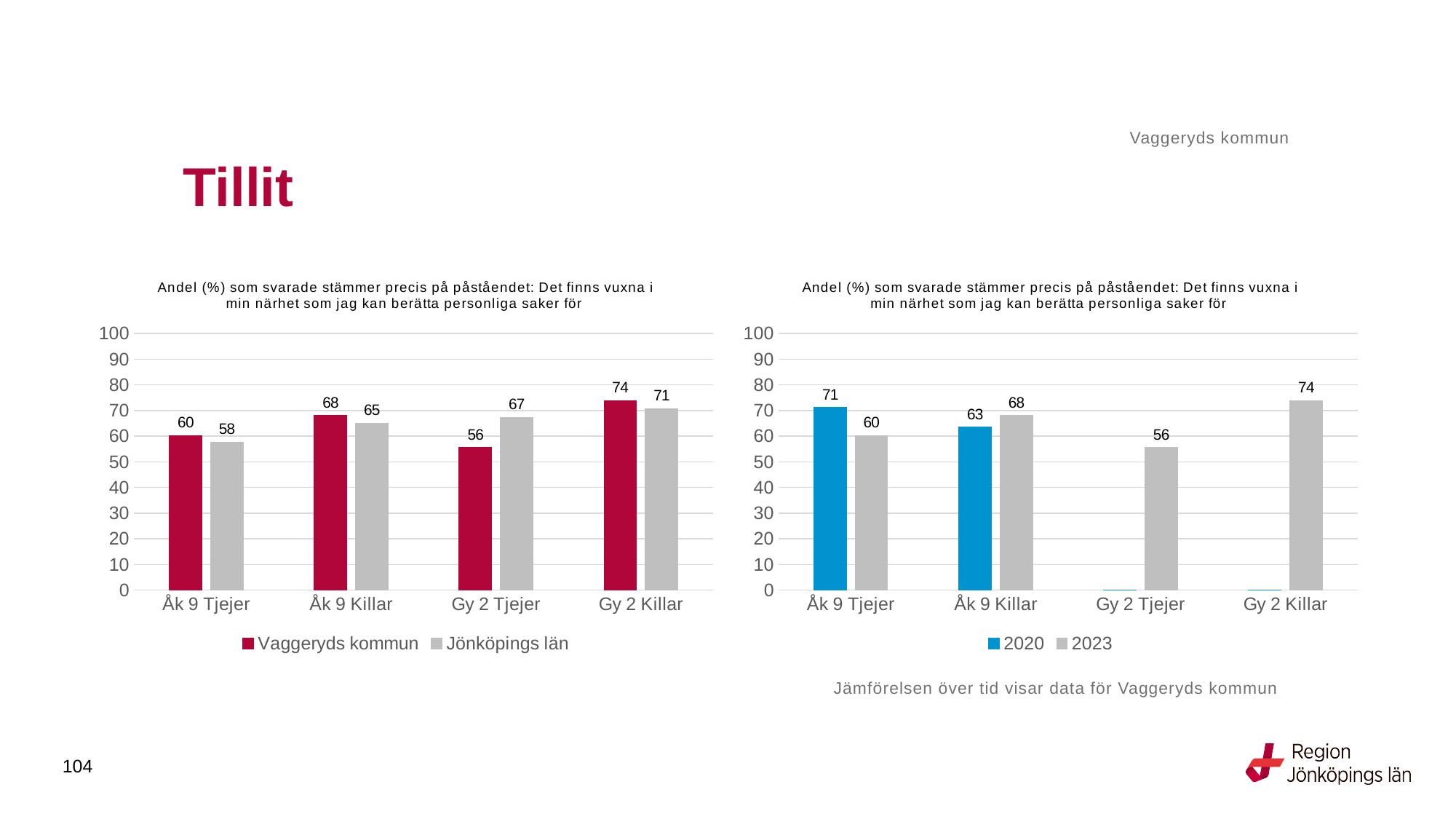
In the right chart, what is the 2023 value for Gy 2 Killar? 74 What kind of chart is the right chart? Bar chart In the left chart, what is the value for Vaggeryds kommun for Åk 9 Tjejer? 60 In the left chart, which category has the highest value for Vaggeryds kommun? Gy 2 Killar In the right chart, what is the 2020 value for Åk 9 Tjejer? 71 How many categories are shown on the x axis of the left chart? 4 In the left chart, which is larger for Åk 9 Killar: Vaggeryds kommun or Jönköpings län? Vaggeryds kommun In the left chart, what is the difference between Jönköpings län and Vaggeryds kommun for Gy 2 Tjejer? 11 In the left chart, which category has the lowest value for Jönköpings län? Åk 9 Tjejer In the right chart, how many series does the legend list? 2 In the right chart, what is the difference between the 2020 and 2023 values for Åk 9 Tjejer? 11 In the left chart, what is the value for Jönköpings län for Gy 2 Tjejer? 67